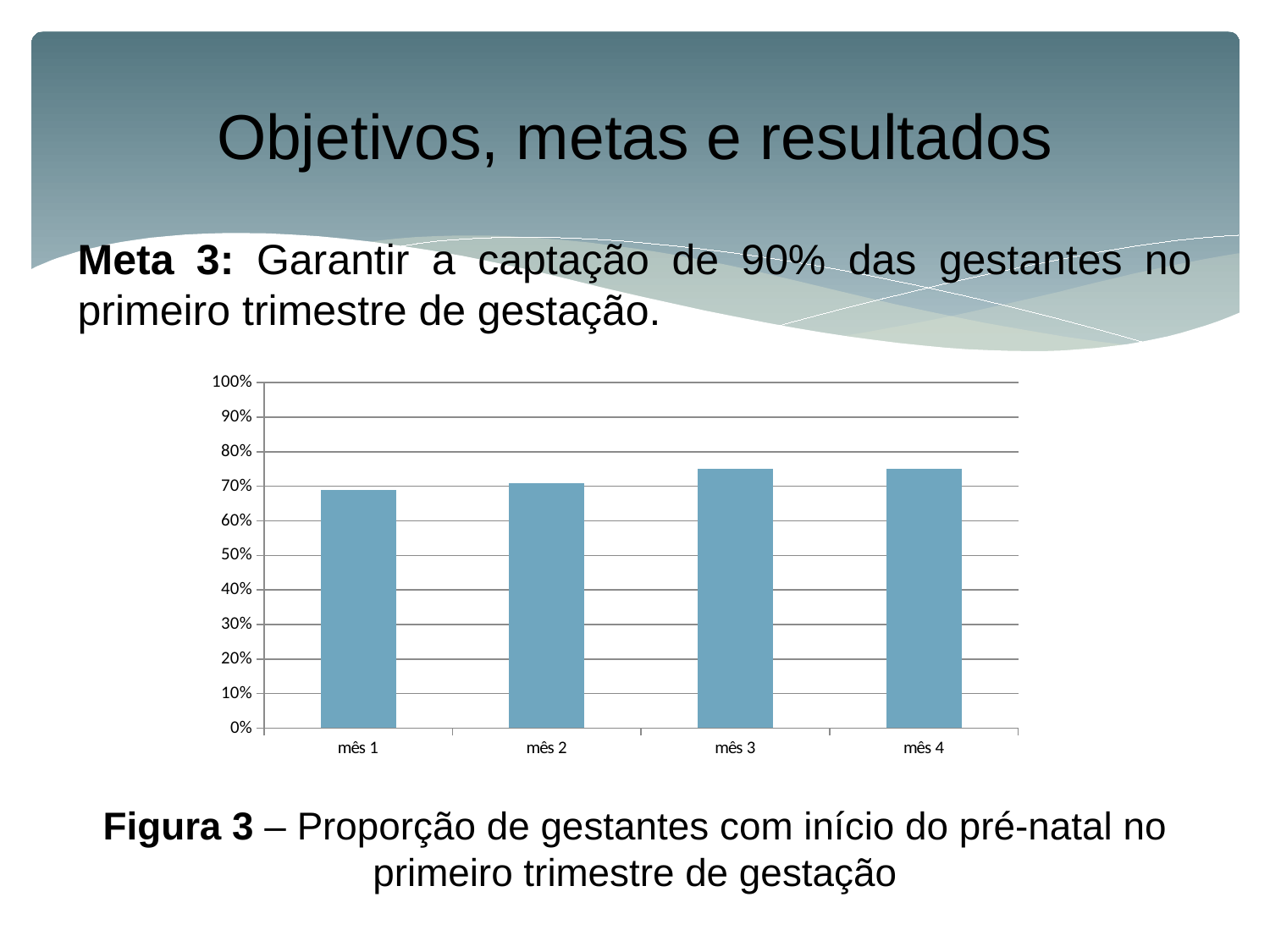
Is the value for mês 3 greater or less than 80%? less What kind of chart is shown on the slide? bar chart Which month has the lowest value in the chart? mês 1 What is the figure caption given below the chart? Figura 3 – Proporção de gestantes com início do pré-natal no primeiro trimestre de gestação Do any of the bars reach the 90% target line shown on the axis? No Is the value for mês 4 greater or less than 90%? less Do the values generally rise or fall from mês 1 to mês 4? rise How many categories (months) are shown on the x axis of the chart? 4 Which is larger, the value for mês 1 or the value for mês 3? mês 3